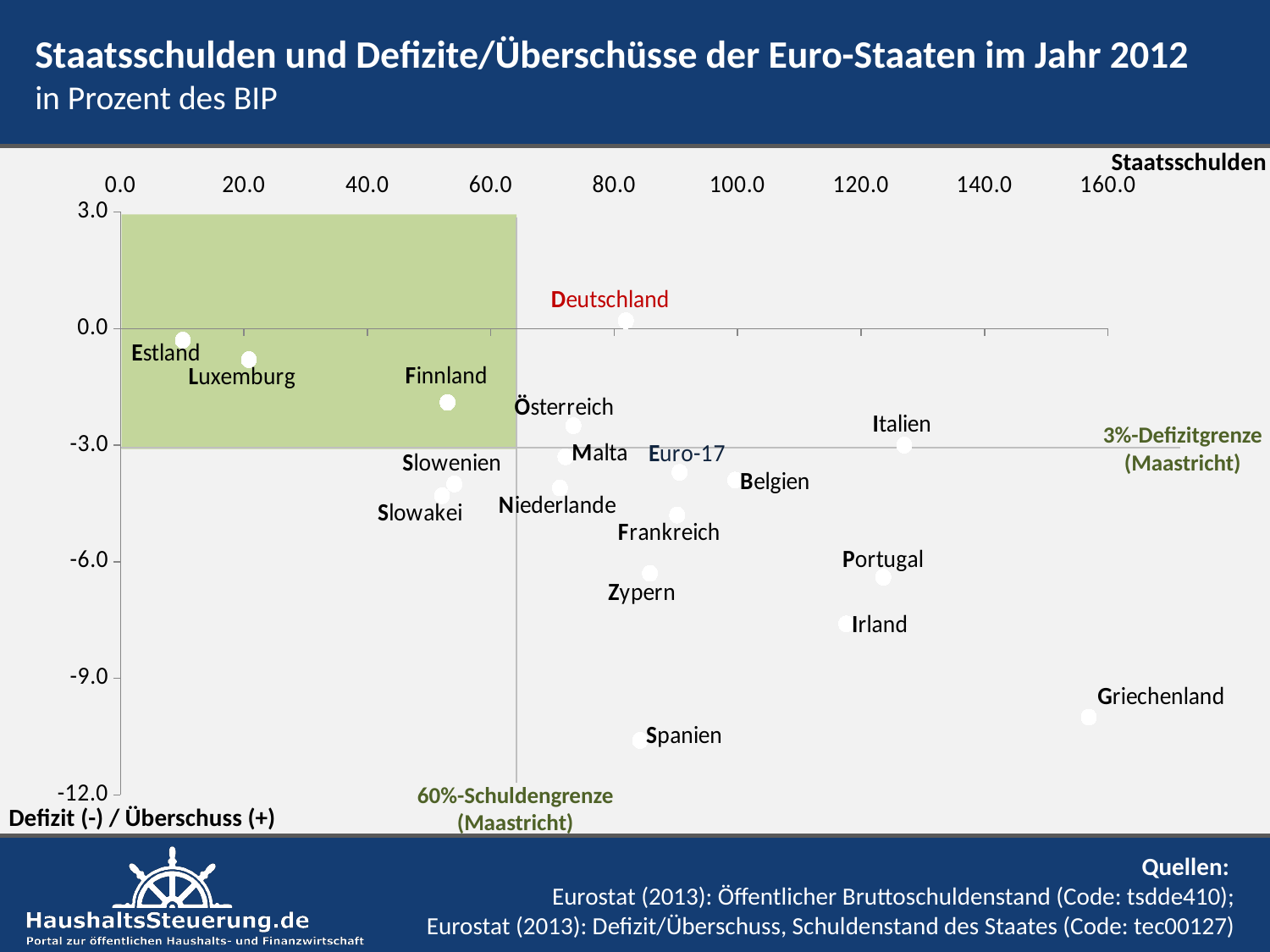
Which country has higher Staatsschulden, Belgien or Frankreich? Belgien Is the Staatsschulden value for Griechenland greater or less than 140.0? greater Which country is the only one plotted above 0.0 on the Defizit/Überschuss axis, i.e. with a surplus? Deutschland Is the Defizit value for Irland greater or less than -6.0? less Is the Staatsschulden value for Estland greater or less than 20.0? less Which country has the highest Staatsschulden (government debt) in the chart? Griechenland Which country has the larger deficit, Zypern or Frankreich? Zypern What kind of chart is shown on the slide? scatter chart Which country has the largest deficit (lowest value on the vertical axis)? Spanien How many countries are plotted inside the green shaded area? 3 Which country has the lowest Staatsschulden in the chart? Estland What does the vertical line at 60.0 on the Staatsschulden axis represent? 60%-Schuldengrenze (Maastricht)